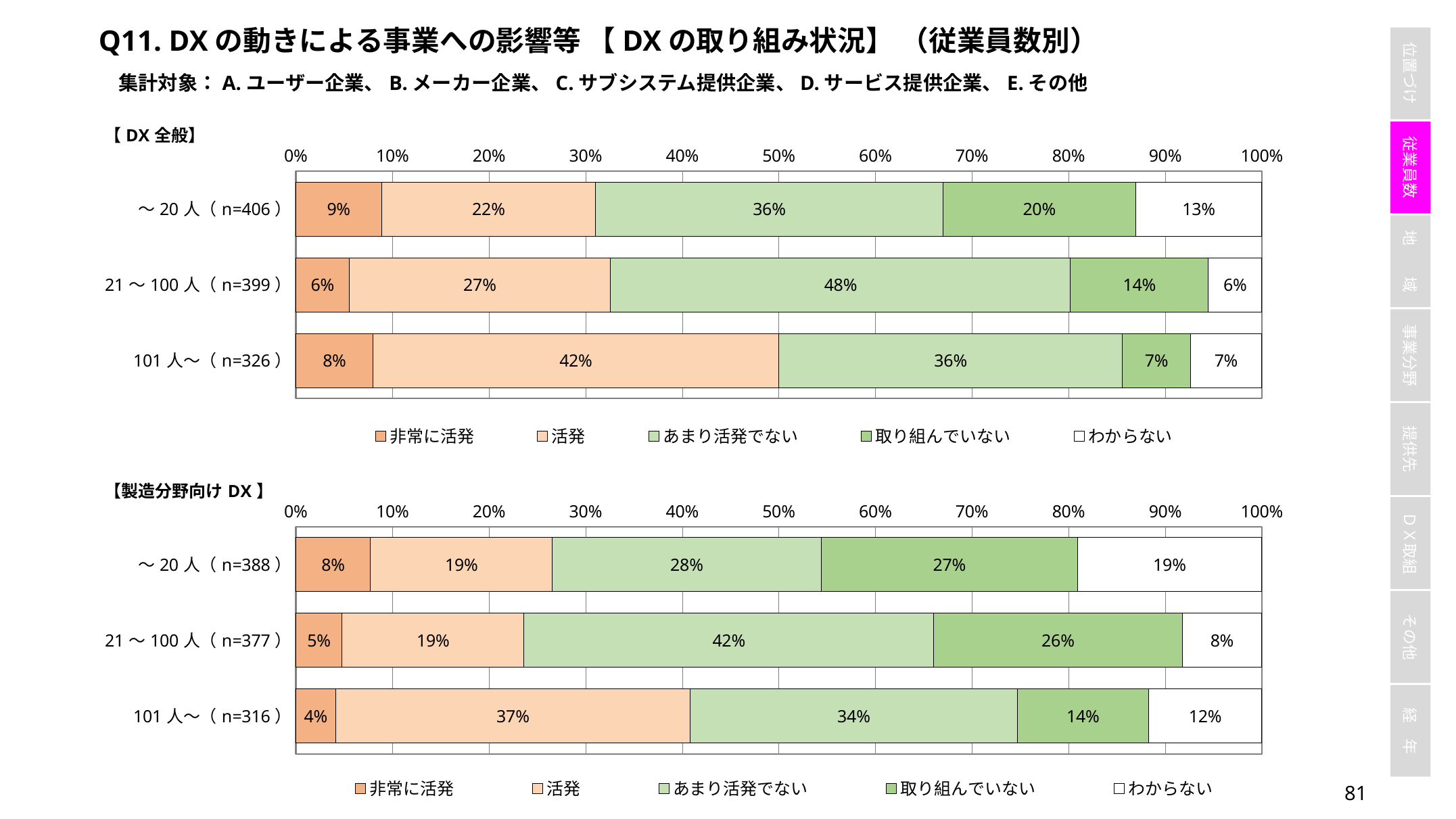
How many series does the legend of the 【DX全般】 chart list? 5 In the 【DX全般】 chart, which category has the highest value for 非常に活発? 〜20人 (n=406) What kind of chart is the 【DX全般】 chart? Stacked bar chart In the 【DX全般】 chart, what is the value for 活発 in the 101人〜 (n=326) category? 42% In the 【DX全般】 chart, what is the difference between the 活発 values for 101人〜 (n=326) and 〜20人 (n=406)? 20% How many categories are shown in the 【製造分野向けDX】 chart? 3 In the 【製造分野向けDX】 chart, what is the value for わからない in the 101人〜 (n=316) category? 12% In the 【DX全般】 chart, what is the value for あまり活発でない in the 21〜100人 (n=399) category? 48% In the 【製造分野向けDX】 chart, which category has the lowest value for 非常に活発? 101人〜 (n=316) In the 【製造分野向けDX】 chart, what is the value for 取り組んでいない in the 〜20人 (n=388) category? 27% In the 【製造分野向けDX】 chart, which is larger: the あまり活発でない value for 21〜100人 (n=377) or for 〜20人 (n=388)? 21〜100人 (n=377) In the 【製造分野向けDX】 chart, does the 活発 value rise or fall from 〜20人 to 101人〜? Rise